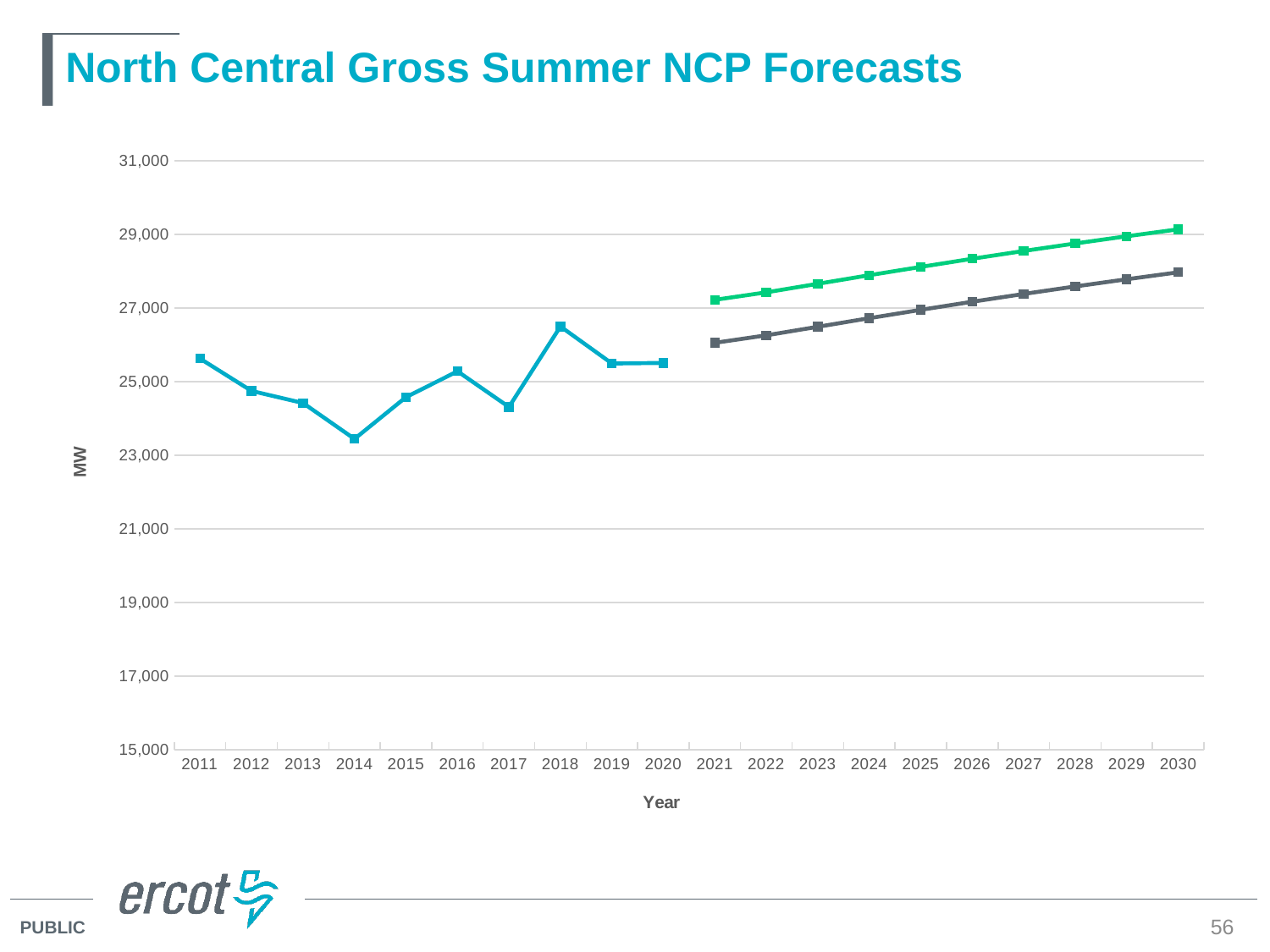
What type of chart is shown on the slide? line chart Is the value for 2025 on the green line greater or less than 27,000? greater What is the label of the y axis? MW In which year does the blue historical line reach its highest value? 2018 In which year does the blue historical line reach its lowest value? 2014 Is the value for 2030 on the dark gray line greater or less than 29,000? less Is the value for 2014 on the blue line greater or less than 25,000? less How many years are shown on the x axis? 20 What is the title of the chart? North Central Gross Summer NCP Forecasts Which line has the larger value in 2030, the green line or the dark gray line? green line How many lines are plotted on the chart? 3